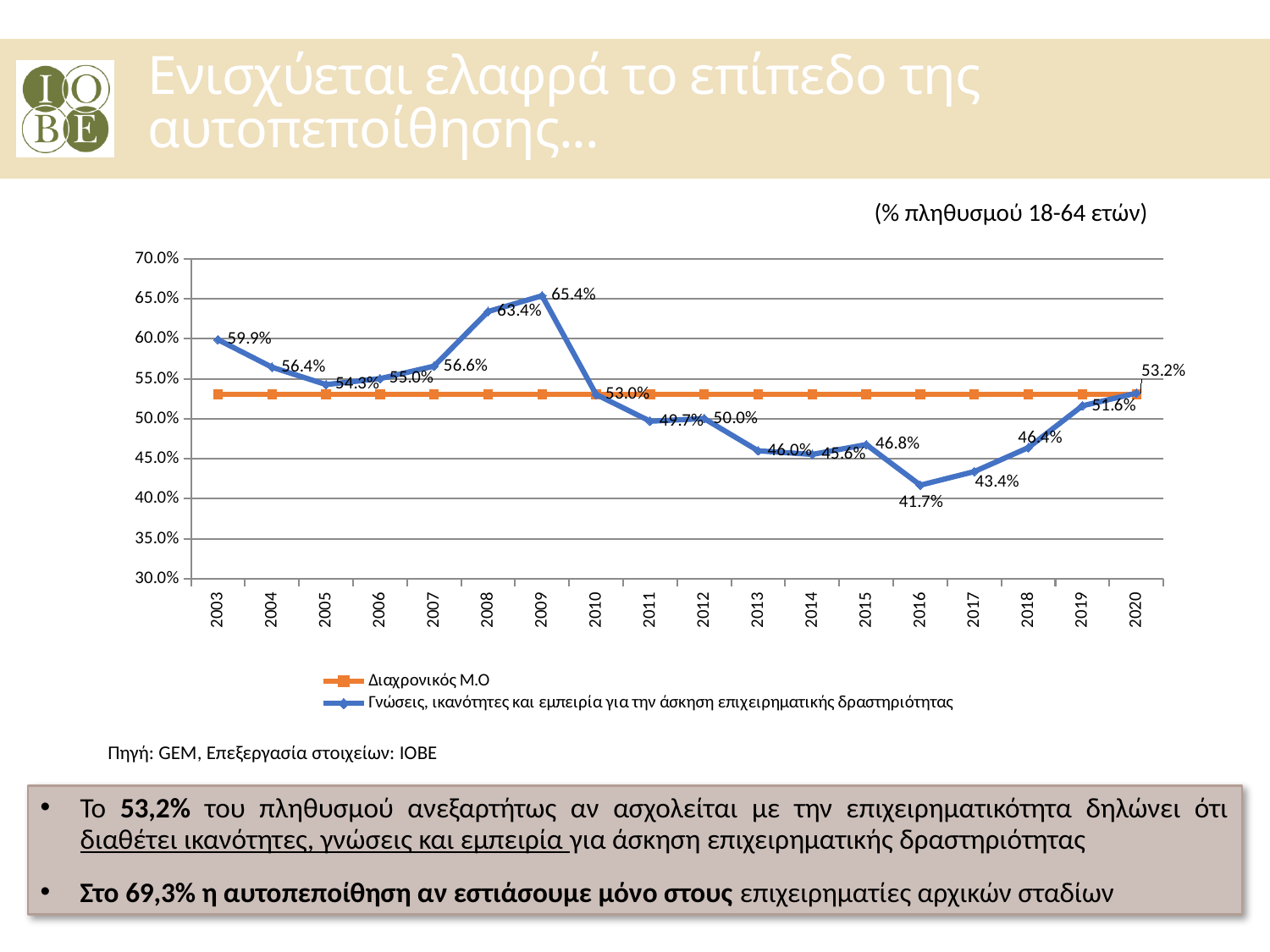
What is the difference between the 2009 value (65.4%) and the 2016 value (41.7%) of the blue series? 23.7 percentage points What type of chart is shown on the slide? Line chart What is the value for 2016 for the series 'Γνώσεις, ικανότητες και εμπειρία για την άσκηση επιχειρηματικής δραστηριότητας'? 41.7% Which year has the larger value for the blue series, 2008 or 2019? 2008 How many series does the legend list? 2 What is the value for 2009 for the series 'Γνώσεις, ικανότητες και εμπειρία για την άσκηση επιχειρηματικής δραστηριότητας'? 65.4% What is the value for 2020 for the series 'Γνώσεις, ικανότητες και εμπειρία για την άσκηση επιχειρηματικής δραστηριότητας'? 53.2% In which year does the series 'Γνώσεις, ικανότητες και εμπειρία για την άσκηση επιχειρηματικής δραστηριότητας' reach its highest value? 2009 What is the value for 2003 for the series 'Γνώσεις, ικανότητες και εμπειρία για την άσκηση επιχειρηματικής δραστηριότητας'? 59.9% In which year does the series 'Γνώσεις, ικανότητες και εμπειρία για την άσκηση επιχειρηματικής δραστηριότητας' reach its lowest value? 2016 Does the blue series rise or fall from 2003 to 2005? Fall How many years are shown on the x axis? 18